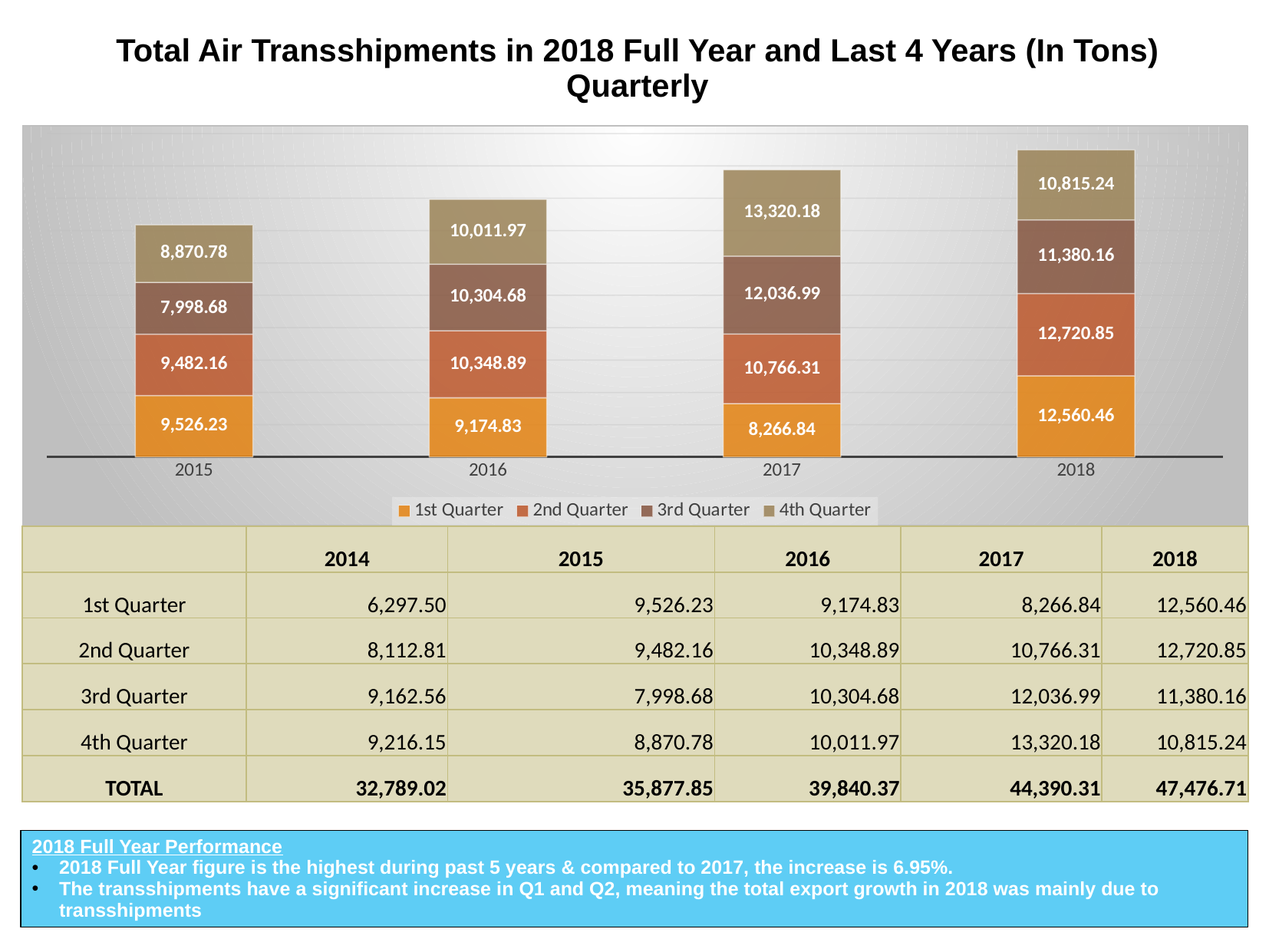
Which year has the shortest stacked bar in the chart? 2015 Which is larger, the 2nd Quarter value for 2016 or the 2nd Quarter value for 2017? 2017 What is the difference between the 1st Quarter values for 2018 and 2017? 4,293.62 What is the 4th Quarter value for 2017 in the chart? 13,320.18 How many years are plotted on the x axis of the chart? 4 Which year has the tallest stacked bar in the chart? 2018 What is the total of the stacked bar for 2018? 47,476.71 How many series does the chart legend list? 4 What is the 1st Quarter value for 2018 in the chart? 12,560.46 What is the 3rd Quarter value for 2015 in the chart? 7,998.68 What type of chart is shown on the slide? Stacked bar chart Which series is shown in orange at the bottom of each stacked bar? 1st Quarter